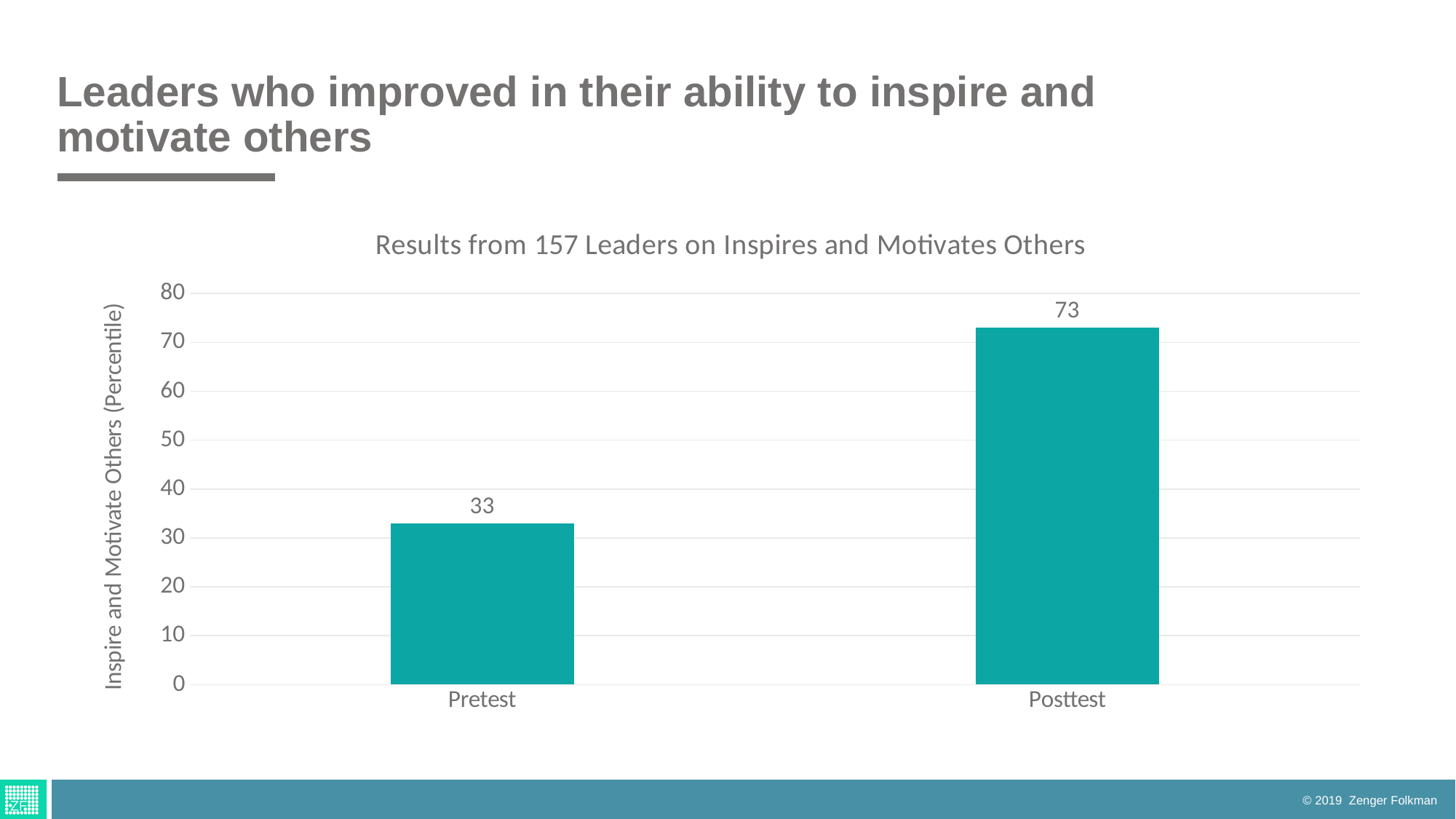
What is the title of the chart? Results from 157 Leaders on Inspires and Motivates Others What is the value for Pretest? 33 Which category has the lowest value? Pretest Is the value for Pretest greater or less than 40? less How many categories are shown on the x axis? 2 What is the difference between the Posttest and Pretest values? 40 What is the value for Posttest? 73 Do the values rise or fall from Pretest to Posttest? Rise Which category has the highest value? Posttest Is the value for Posttest greater or less than 70? greater What kind of chart is shown on the slide? Bar chart Which is larger, the value for Pretest or the value for Posttest? Posttest